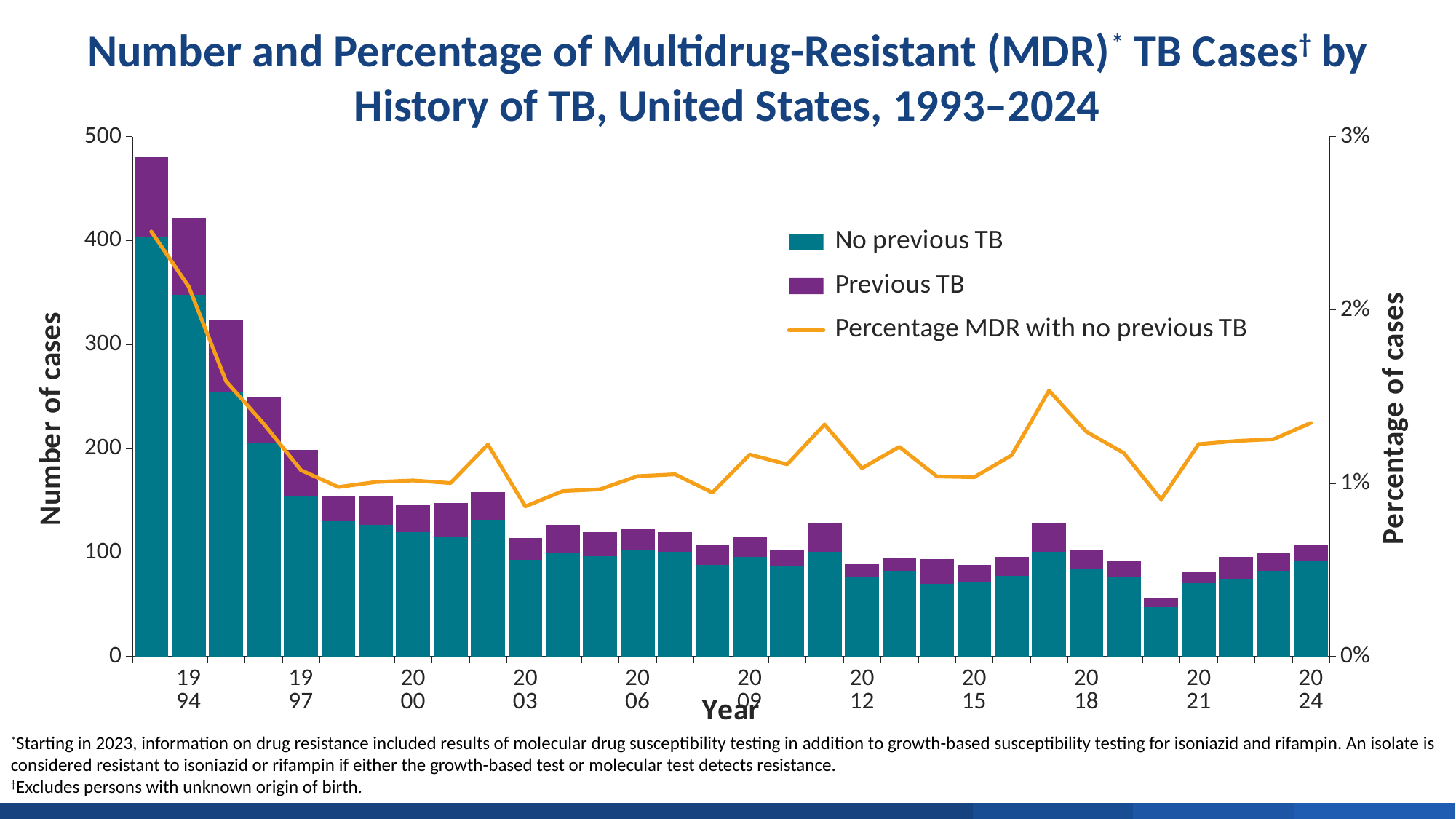
What is the label of the right-hand vertical axis? Percentage of cases How many series does the legend list? 3 Is the total number of cases in 1993 greater or less than 400? greater Is the percentage of MDR with no previous TB in 1993 greater or less than 2%? greater How many years (bars) are plotted on the chart? 32 Which year has the lowest total number of MDR TB cases? 2020 Which year has the highest total number of MDR TB cases? 1993 Which year has a larger total number of cases, 1993 or 2024? 1993 Is the percentage of MDR with no previous TB in 2020 greater or less than 1%? less What kind of chart is shown on the slide? A bar chart combined with a line Do the total numbers of cases rise or fall from 1993 to 1997? fall